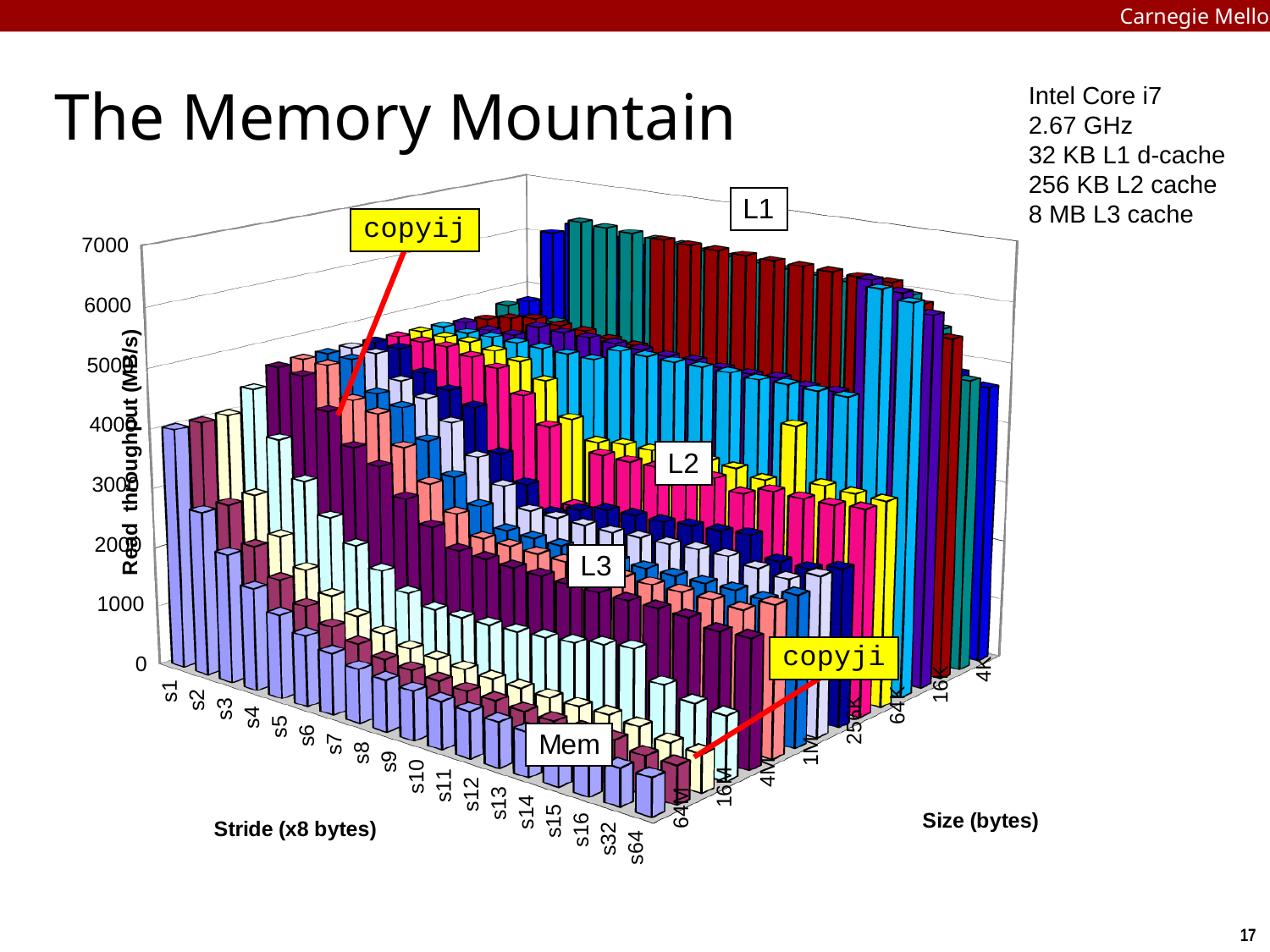
How many stride categories are shown along the Stride (x8 bytes) axis? 18 For a fixed size, does read throughput generally rise or fall as the stride increases from s1 to s64? fall What is the first stride category on the Stride (x8 bytes) axis? s1 What is the title of the chart on the slide? The Memory Mountain What is the smallest size category shown on the Size (bytes) axis? 4K What kind of chart is shown on the slide? 3D bar chart For a fixed stride, does read throughput generally rise or fall as the size decreases from 64M to 4K? rise Is the read throughput for stride s1 at size 4K greater or less than 5000? less What is the last stride category on the Stride (x8 bytes) axis? s64 What is the label of the vertical axis of the chart? Read throughput (MB/s) What is the highest tick value shown on the Read throughput axis? 7000